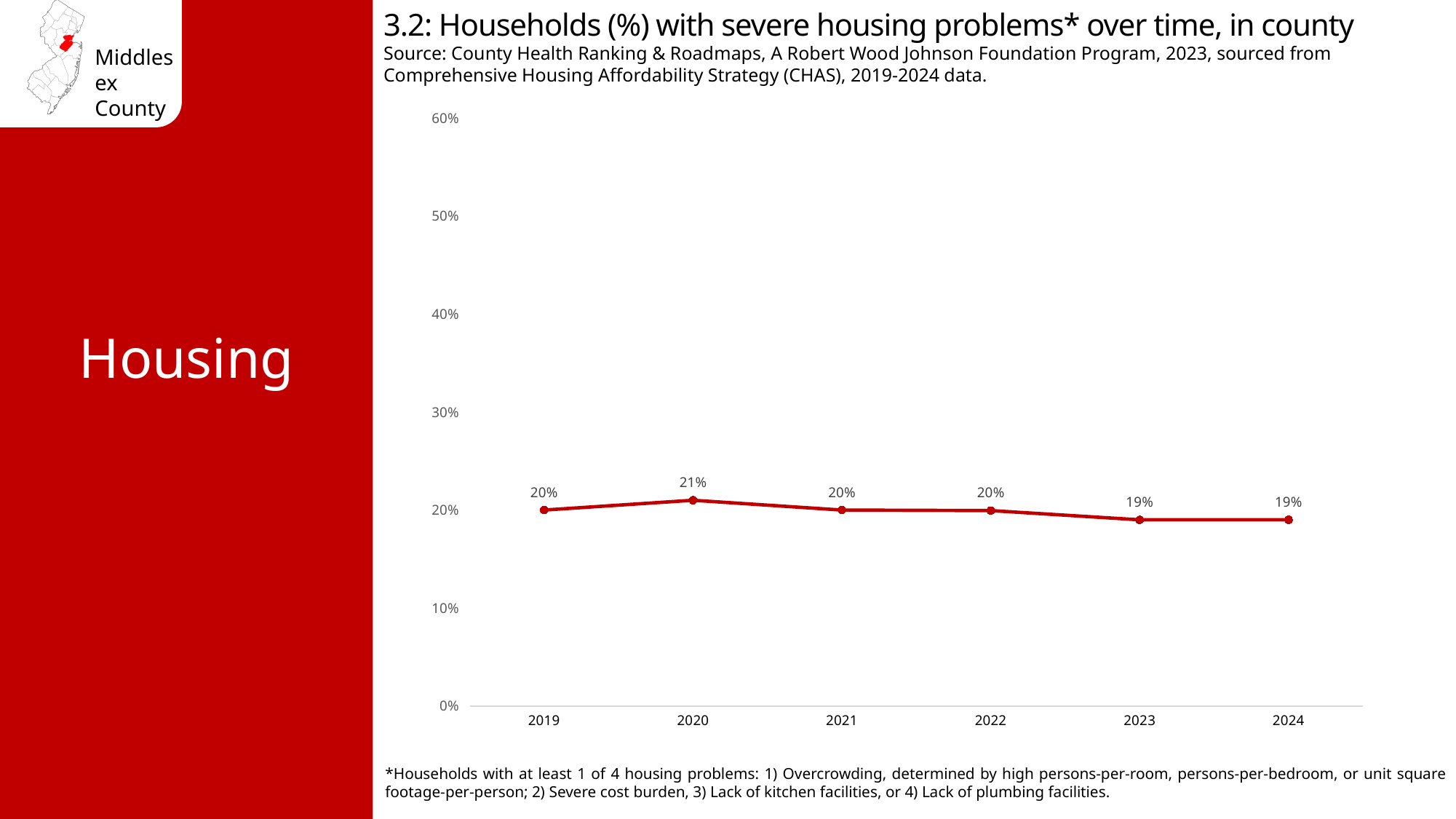
What kind of chart is shown on the slide? line chart What percentage of households had severe housing problems in 2020? 21% What is the title of the chart? 3.2: Households (%) with severe housing problems* over time, in county Is the value for 2021 larger or smaller than the value for 2020? smaller What is the value shown for 2024? 19% How many years are plotted on the chart? 6 Is the value for 2022 greater or less than 30%? less Does the value rise or fall from 2022 to 2023? fall What is the value shown for 2019? 20% Which year has the highest percentage of households with severe housing problems? 2020 What is the highest value shown on the vertical axis? 60% What is the difference between the 2020 value and the 2023 value? 2%